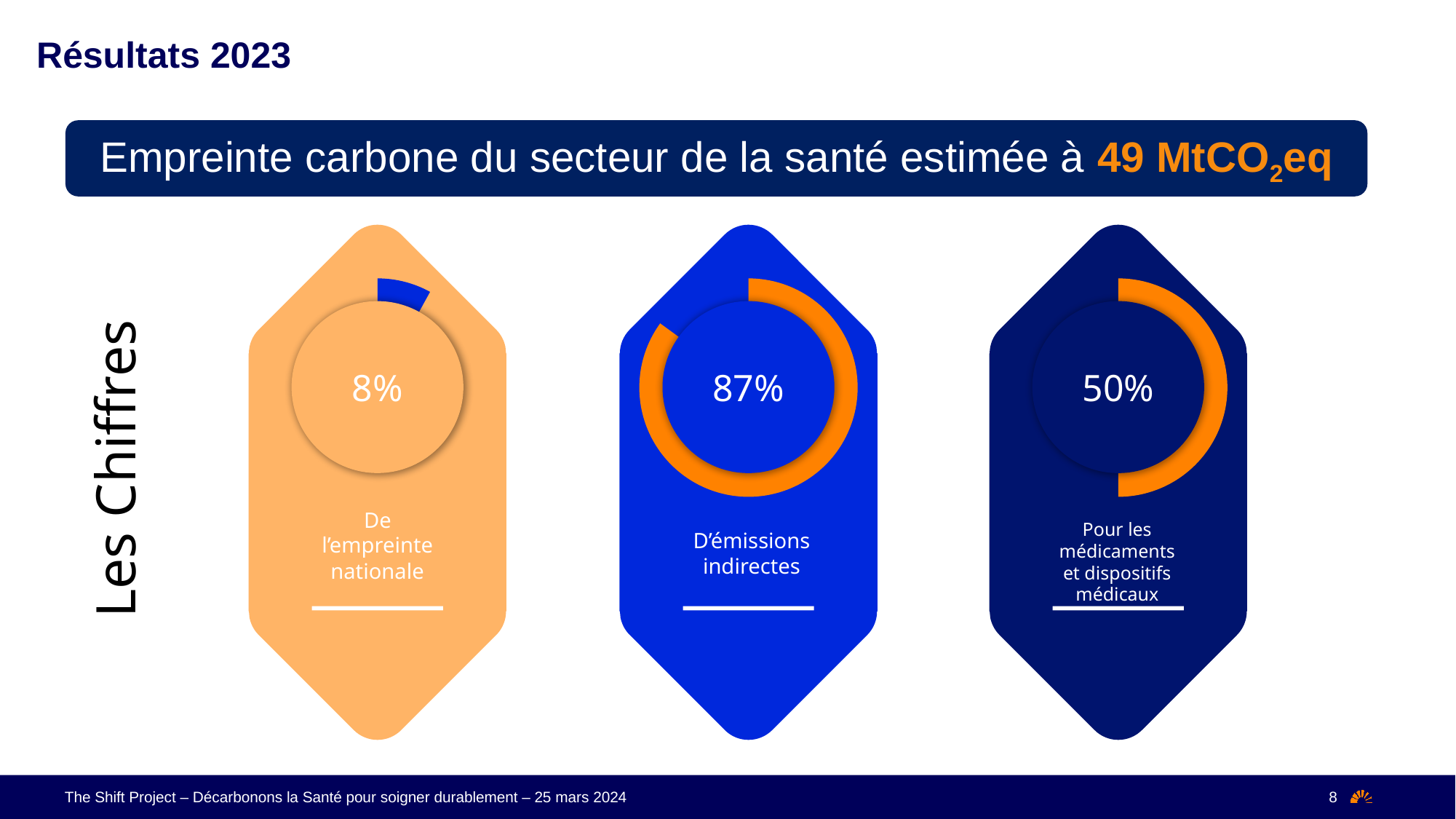
What is the difference between the percentage for 'D'émissions indirectes' and the percentage for 'De l'empreinte nationale'? 79 percentage points According to the banner above the charts, what is the estimated carbon footprint of the health sector? 49 MtCO2eq What percentage is shown in the middle chart labelled 'D'émissions indirectes'? 87% Which of the three ring charts shows the highest percentage? D'émissions indirectes (87%) What kind of chart is used to display the three percentages? Ring (donut) chart Which is larger: the percentage for 'Pour les médicaments et dispositifs médicaux' or the percentage for 'De l'empreinte nationale'? Pour les médicaments et dispositifs médicaux What percentage is shown in the right chart labelled 'Pour les médicaments et dispositifs médicaux'? 50% What is the difference between the percentage for 'D'émissions indirectes' and the percentage for 'Pour les médicaments et dispositifs médicaux'? 37 percentage points Which of the three ring charts shows the lowest percentage? De l'empreinte nationale (8%) What percentage is shown in the left chart labelled 'De l'empreinte nationale'? 8% What colour is the filled portion of the ring in the middle chart showing 87%? Orange How many ring charts are shown on the slide? 3